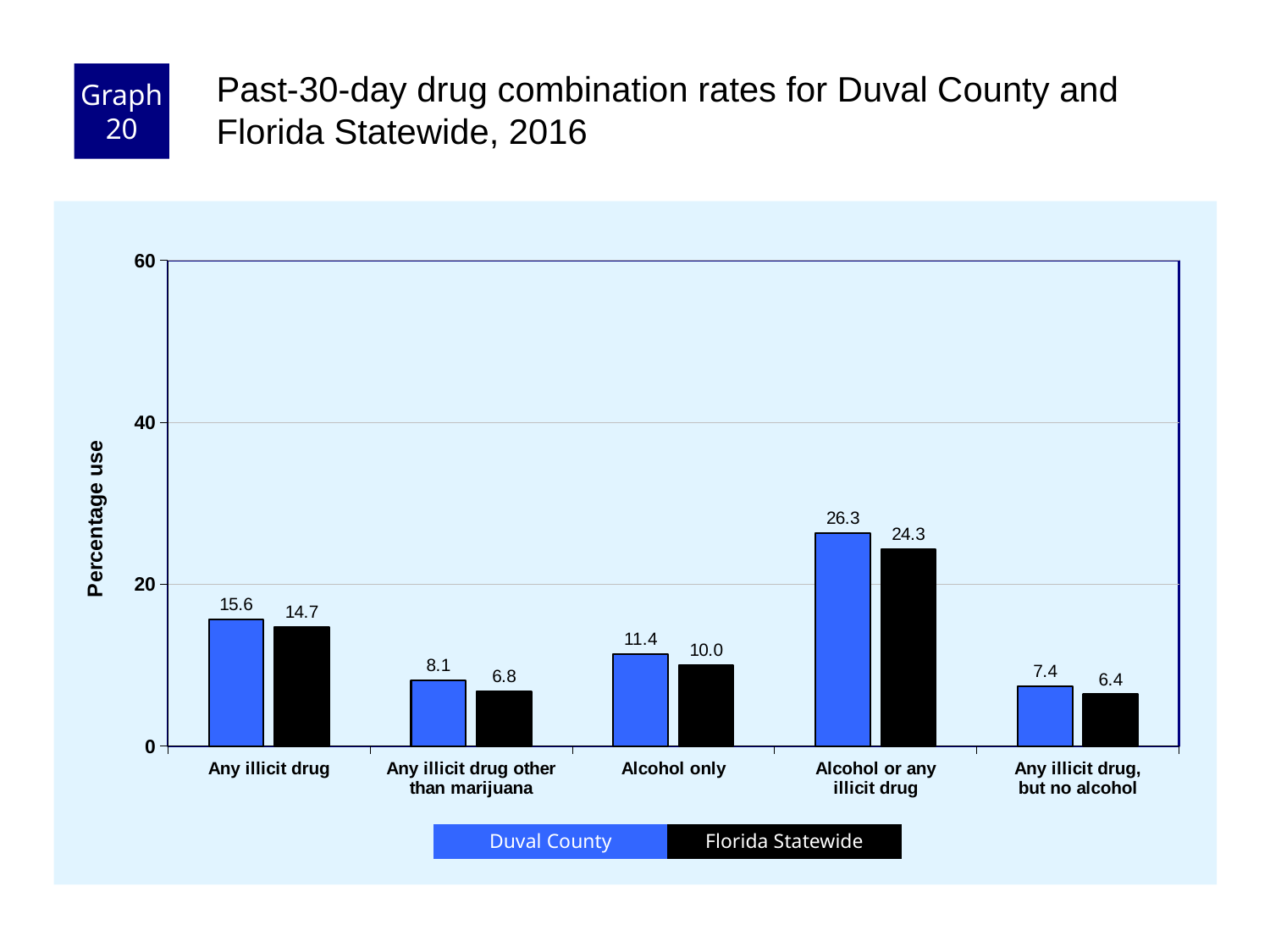
What is the Florida Statewide value for Alcohol only? 10.0 Which category has the highest Duval County value? Alcohol or any illicit drug Which is larger for Any illicit drug other than marijuana: Duval County or Florida Statewide? Duval County What is the Duval County value for Any illicit drug? 15.6 What kind of chart is shown on the slide? bar chart Is the Florida Statewide value for Alcohol or any illicit drug greater or less than 20? greater How many categories are shown on the x axis? 5 What is the difference between the Duval County and Florida Statewide values for Alcohol or any illicit drug? 2.0 What is the Florida Statewide value for Any illicit drug, but no alcohol? 6.4 Which category has the lowest Florida Statewide value? Any illicit drug, but no alcohol How many series does the legend list? 2 What is the label of the y axis? Percentage use